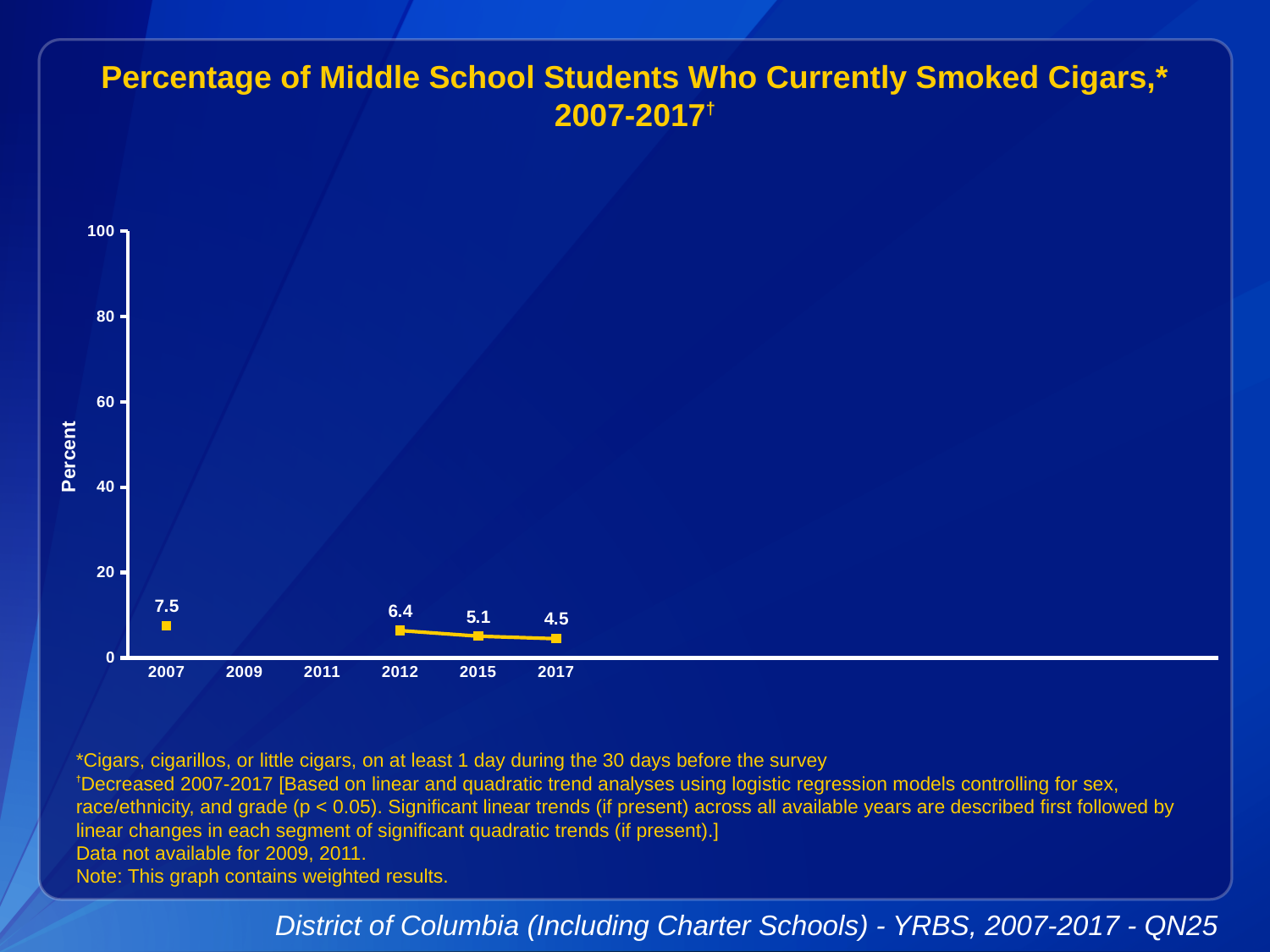
Which is larger, the value for 2012 or the value for 2015? 2012 How many data points are plotted on the chart? 4 Which year has the lowest value? 2017 What is the value for 2017? 4.5 What is the value for 2007? 7.5 What is the value for 2015? 5.1 What kind of chart is shown? line chart What is the difference between the values for 2007 and 2017? 3.0 Is the value for 2007 greater or less than 20? less Do the values rise or fall from 2007 to 2017? fall Which year has the highest value? 2007 What is the value for 2012? 6.4